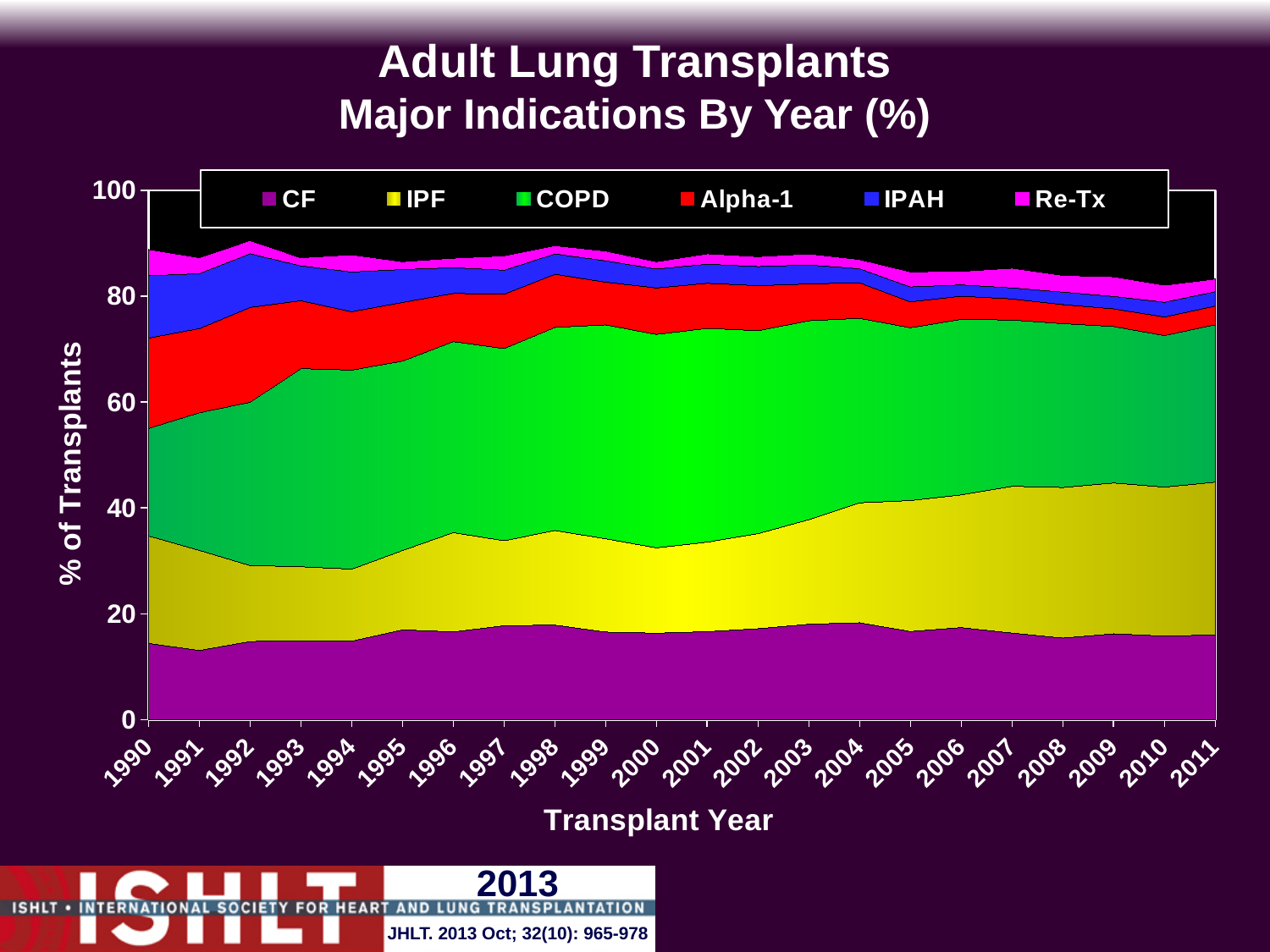
Does the share of transplants for IPF rise or fall from 1990 to 2011? rise What is the first year shown on the x axis? 1990 What is the last year shown on the x axis? 2011 What kind of chart is shown on the slide? Stacked area chart What is the label on the y axis? % of Transplants Is the value for CF in 2011 greater or less than 20? less Does the share of transplants for Alpha-1 rise or fall from 1990 to 2011? fall Which series is shown in purple in the legend? CF Is the value for CF in 1990 greater or less than 20? less How many transplant years are plotted along the x axis? 22 What is the title of the chart? Adult Lung Transplants Major Indications By Year (%) How many series does the legend list? 6